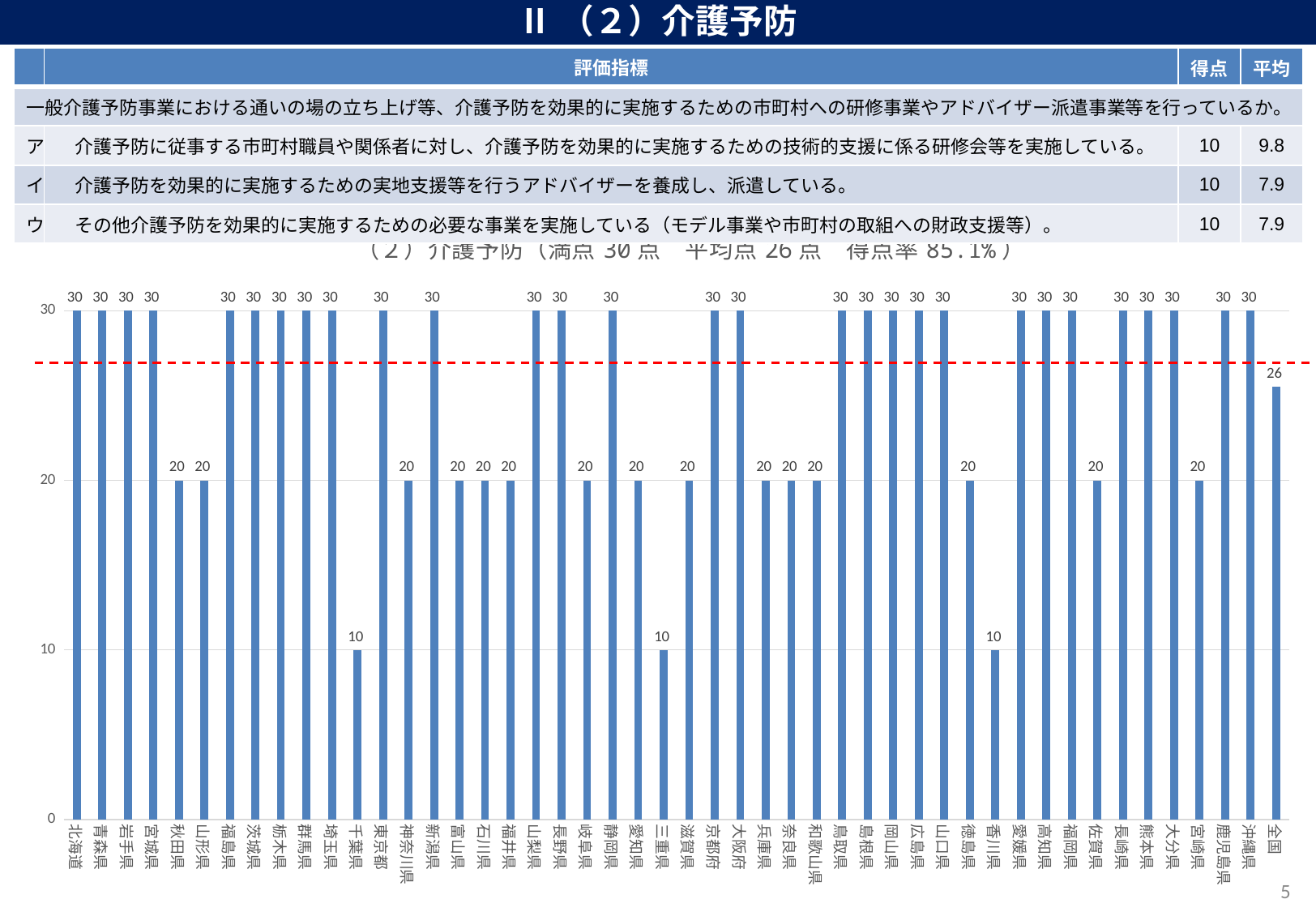
What kind of chart is shown on the slide? bar chart How many bars are plotted in the chart? 48 What is the value for 沖縄県 in the chart? 30 What is the value for 千葉県 in the chart? 10 Is the value for 全国 greater or less than 20? greater What is the difference between the values for 全国 and 香川県? 16 What is the value for 東京都 in the chart? 30 What is the value for 全国 in the chart? 26 Which has the larger value, 香川県 or 徳島県? 徳島県 What is the difference between the values for 北海道 and 三重県? 20 What is the value for 秋田県 in the chart? 20 How many prefectures have a value of 10 in the chart? 3